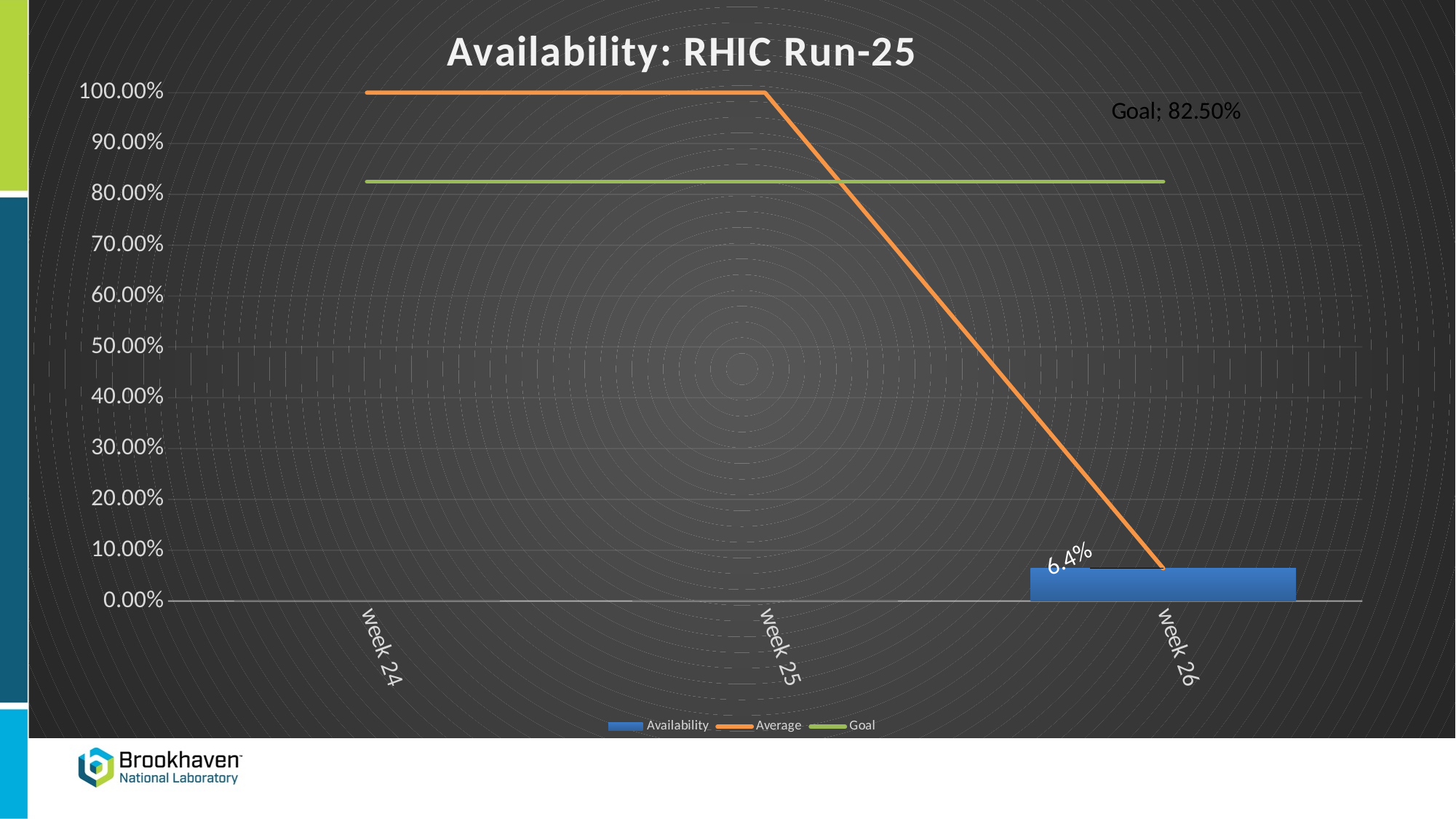
What is the value of the Goal line? 82.50% What colour is the Average series in the legend? Orange What kind of chart is shown on the slide? A combined bar and line chart What is the title of the chart? Availability: RHIC Run-25 What is the Availability value for week 26? 6.4% What is the Average value at week 24? 100.00% What is the difference between the Goal value and the Availability value for week 26? 76.1% Is the Average value at week 26 greater or less than 10.00%? less How many series does the legend list? 3 Which is larger, the Goal value or the Availability value for week 26? Goal How many weeks are shown on the x axis? 3 Does the Average line rise or fall from week 25 to week 26? Fall